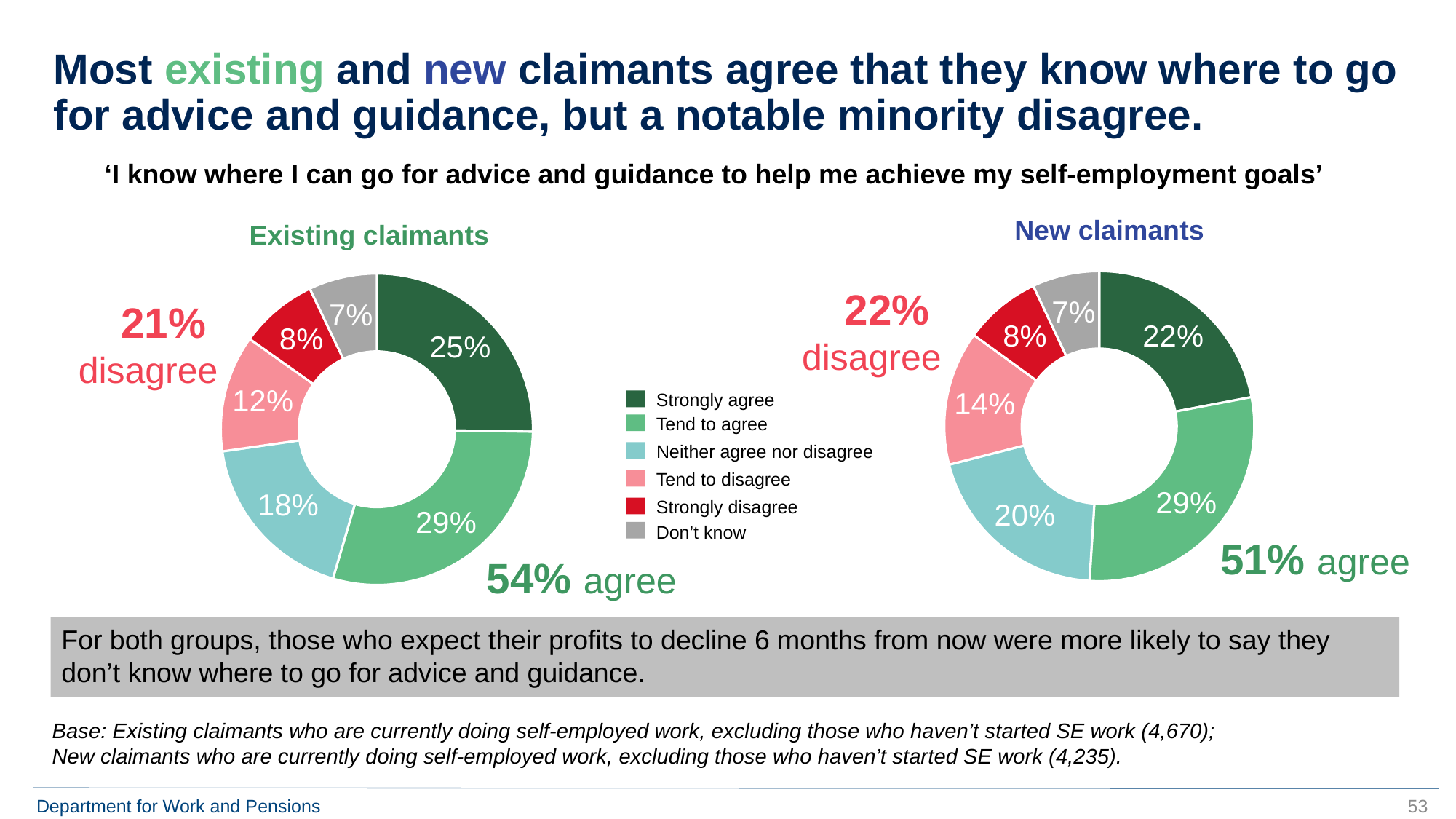
In the New claimants chart, what percentage of respondents neither agree nor disagree? 20% How many response categories does the legend list? 6 In the New claimants chart, what is the combined share of Tend to disagree and Strongly disagree? 22% In the New claimants chart, what percentage of respondents tend to disagree? 14% What is the difference between the Strongly agree share for Existing claimants and for New claimants? 3 percentage points In the Existing claimants chart, which response category has the largest share? Tend to agree Which chart has the larger share for Neither agree nor disagree, Existing claimants or New claimants? New claimants In the Existing claimants chart, what is the combined share of Strongly agree and Tend to agree? 54% What kind of chart is used to show the Existing claimants data? Doughnut (pie) chart In the New claimants chart, which response category has the smallest share? Don't know In the Existing claimants chart, what percentage of respondents strongly agree? 25% Which colour represents Strongly disagree in the legend? Red